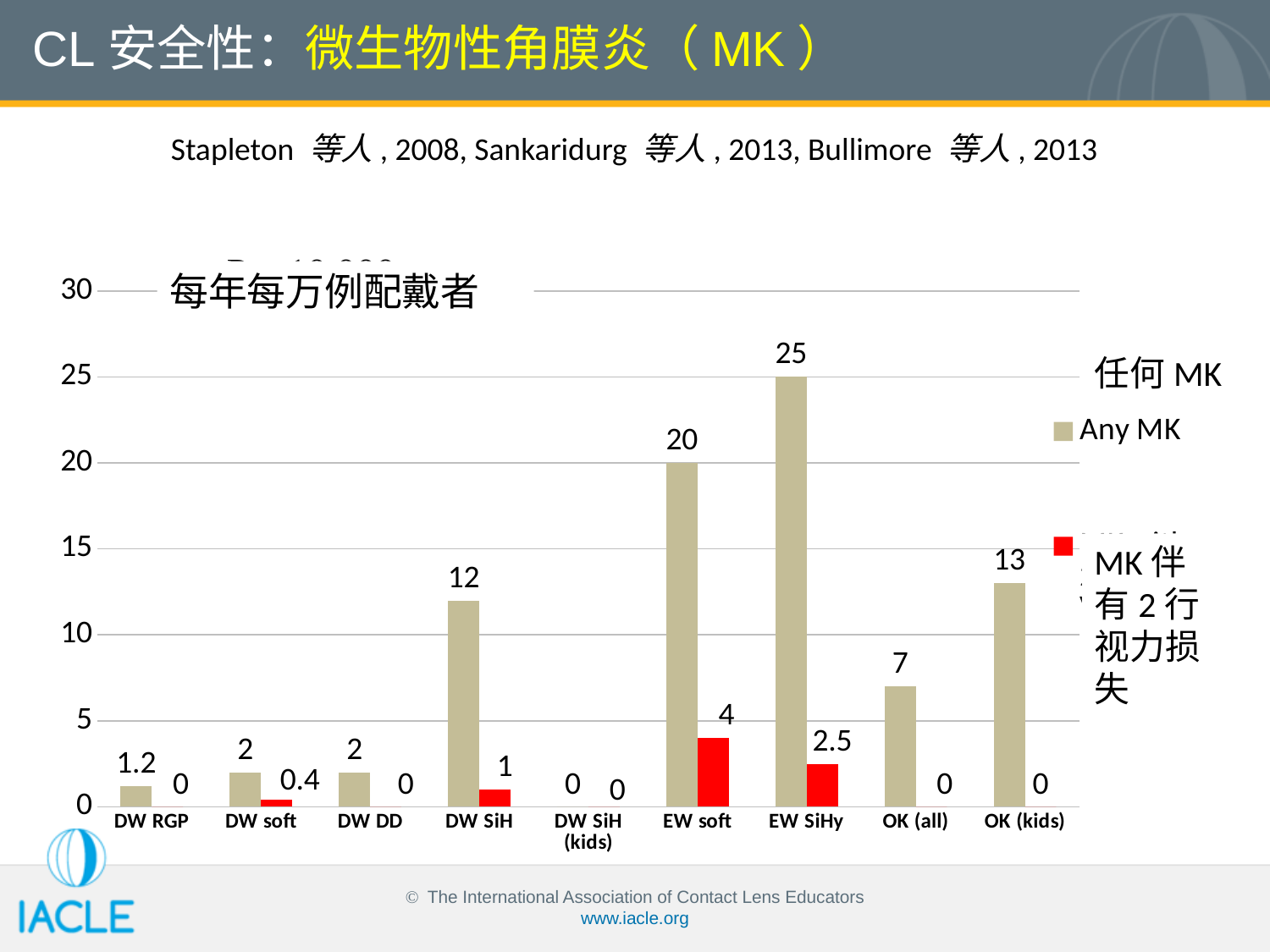
What is the value of the red series for EW soft? 4 Which is larger, the Any MK value for OK (kids) or for OK (all)? OK (kids) Which category has the highest value in the red series? EW soft What is the difference between the Any MK values for EW SiHy and EW soft? 5 Which category has the highest Any MK value? EW SiHy What is the value of the red series for DW soft? 0.4 What kind of chart is shown on the slide? Bar chart What is the Any MK value for DW SiH? 12 What colour are the Any MK bars? Tan How many series does the legend list? 2 How many categories are shown on the x axis? 9 What is the Any MK value for EW SiHy? 25